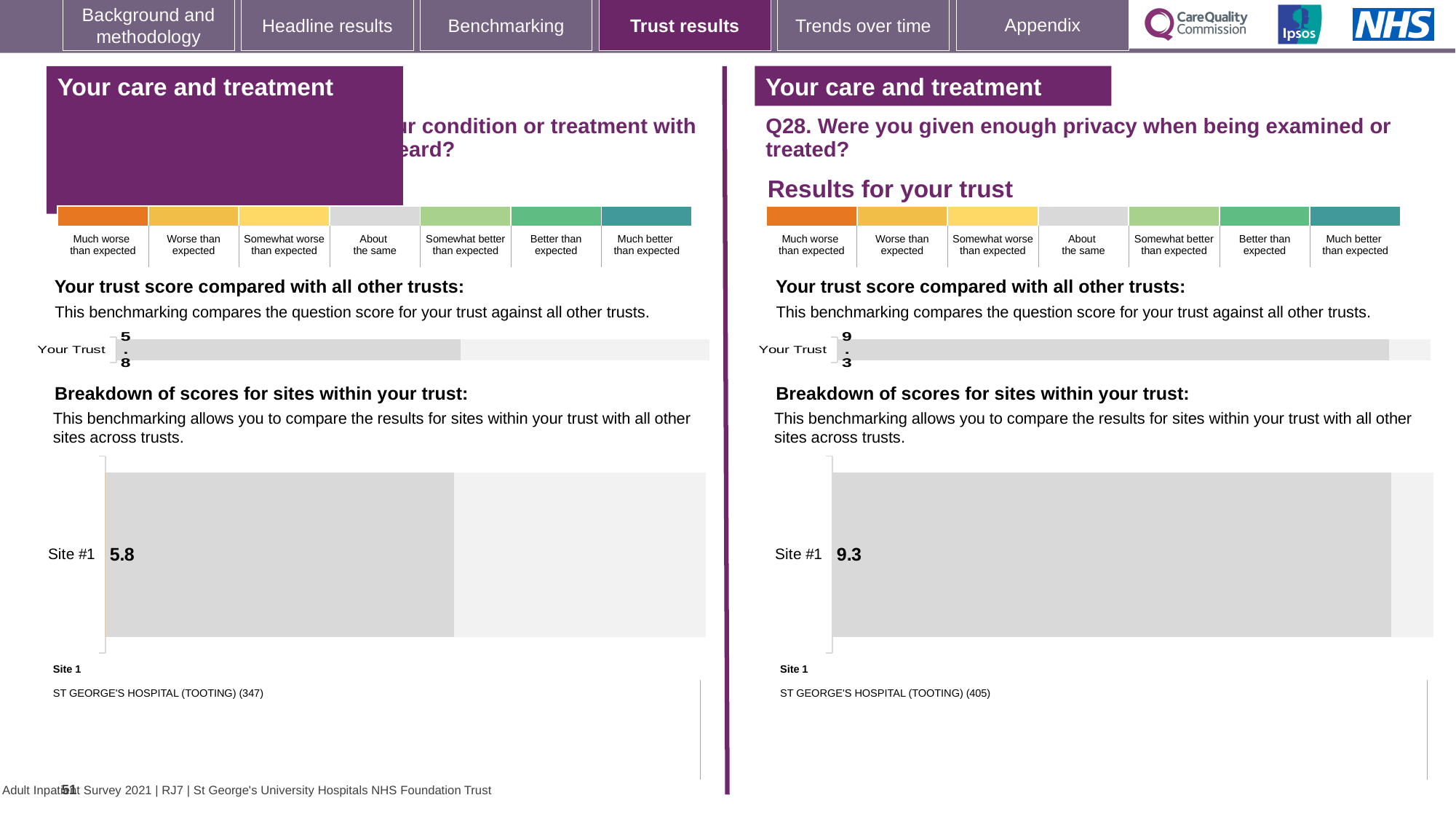
What is the difference between the Site #1 score on the right-hand side (Q28) and the Site #1 score on the left-hand side of the slide? 3.5 On the left-hand side of the slide, which site name is listed as Site 1 below the breakdown chart? ST GEORGE'S HOSPITAL (TOOTING) (347) Which is larger: the Site #1 score on the left-hand side of the slide or the Site #1 score on the right-hand side (Q28)? Right-hand side (Q28) On the right-hand side of the slide (Q28), what score is shown for Site #1 in the breakdown of scores for sites within your trust? 9.3 On the right-hand side of the slide (Q28, privacy when being examined or treated), what is the score shown for Your Trust? 9.3 On the left-hand side of the slide, what score is shown for Site #1 in the breakdown of scores for sites within your trust? 5.8 On the right-hand side of the slide (Q28), which site name is listed as Site 1 below the breakdown chart? ST GEORGE'S HOSPITAL (TOOTING) (405) On the left-hand side of the slide, what is the score shown for Your Trust in the 'Your trust score compared with all other trusts' chart? 5.8 What kind of chart is used to show the Site #1 score on the right-hand side of the slide (Q28)? Bar chart Is the Your Trust score on the right-hand side of the slide (Q28) greater or less than the Your Trust score on the left-hand side? greater How many sites are shown in the breakdown of scores chart on the right-hand side of the slide (Q28)? 1 How many sites are shown in the breakdown of scores chart on the left-hand side of the slide? 1